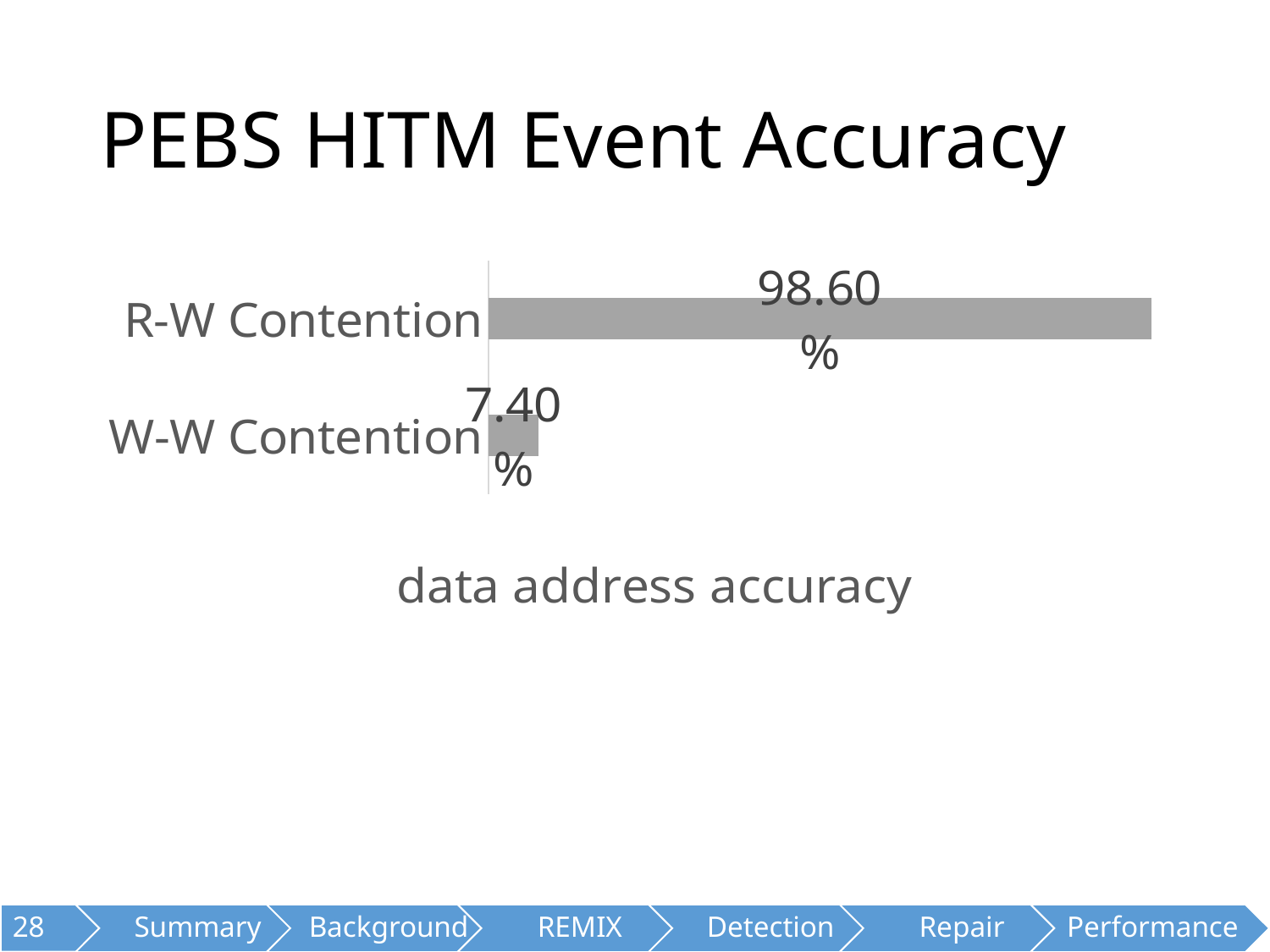
How many categories are shown in the chart? 2 What is the data address accuracy for W-W Contention? 7.40% Which has a larger data address accuracy, R-W Contention or W-W Contention? R-W Contention What is the data address accuracy for R-W Contention? 98.60% Which category has the highest data address accuracy? R-W Contention Which category has the lowest data address accuracy? W-W Contention What colour are the bars in the chart? Grey What kind of chart is shown on the slide? Bar chart What is the difference in data address accuracy between R-W Contention and W-W Contention? 91.20% What is the title of the chart? data address accuracy